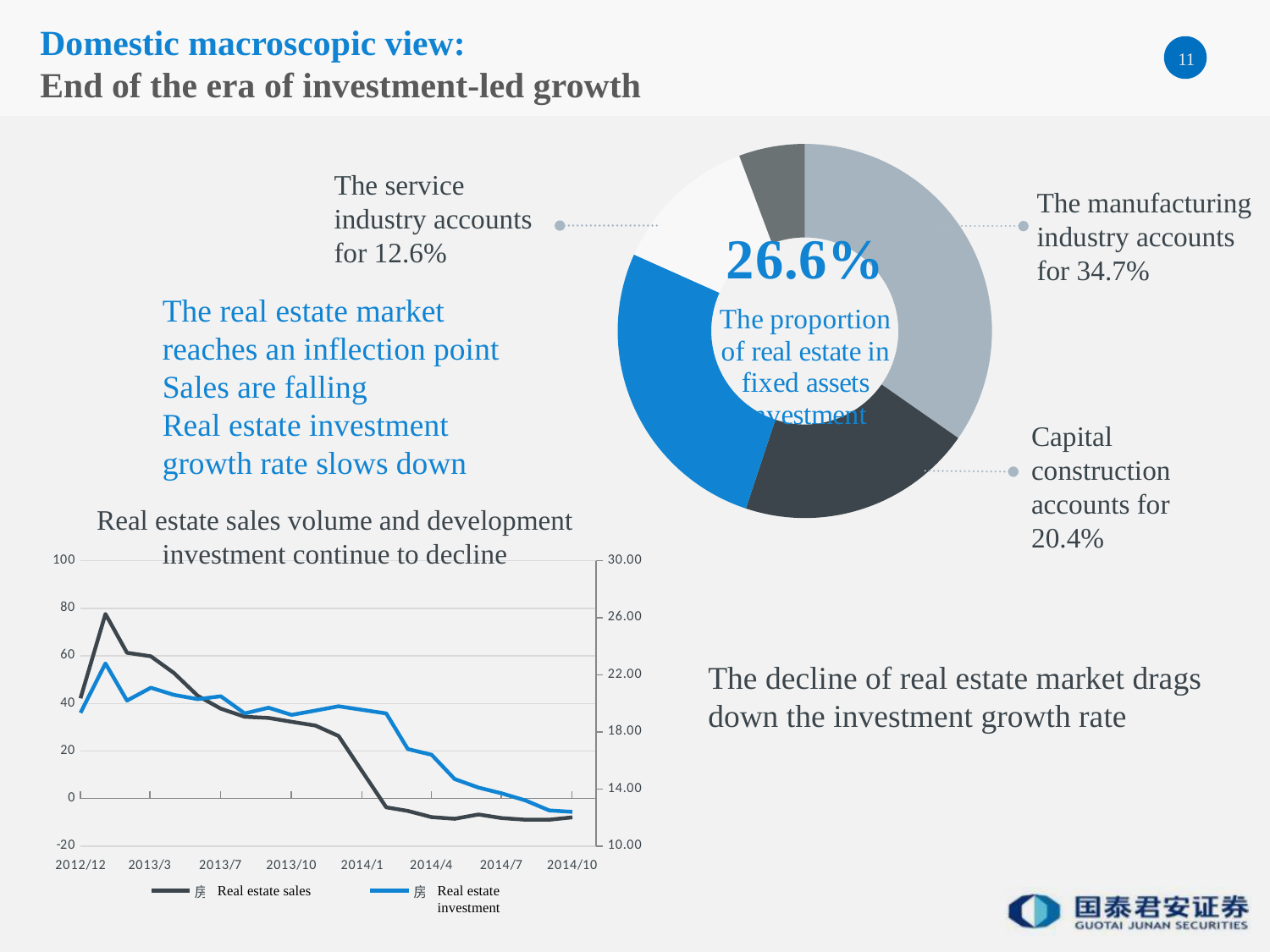
In the donut chart, what is the proportion of real estate in fixed assets investment? 26.6% In the donut chart, what share does the service industry account for? 12.6% What type of chart is the chart titled 'Real estate sales volume and development investment continue to decline'? Line chart In the line chart, do the Real estate sales values generally rise or fall from 2013/3 to 2014/10? Fall In the donut chart, which labelled sector has the largest share? The manufacturing industry In the line chart, is the Real estate sales value at 2014/10 greater or less than 0 on the left axis? less In the donut chart, what share does capital construction account for? 20.4% In the donut chart, what share does the manufacturing industry account for? 34.7% In the donut chart, how many percentage points larger is the manufacturing industry's share than the real estate share? 8.1 In the donut chart, which is larger: the share of capital construction or the share of the service industry? Capital construction In the donut chart, which labelled sector has the smallest share? The service industry How many series does the legend of the line chart list? 2